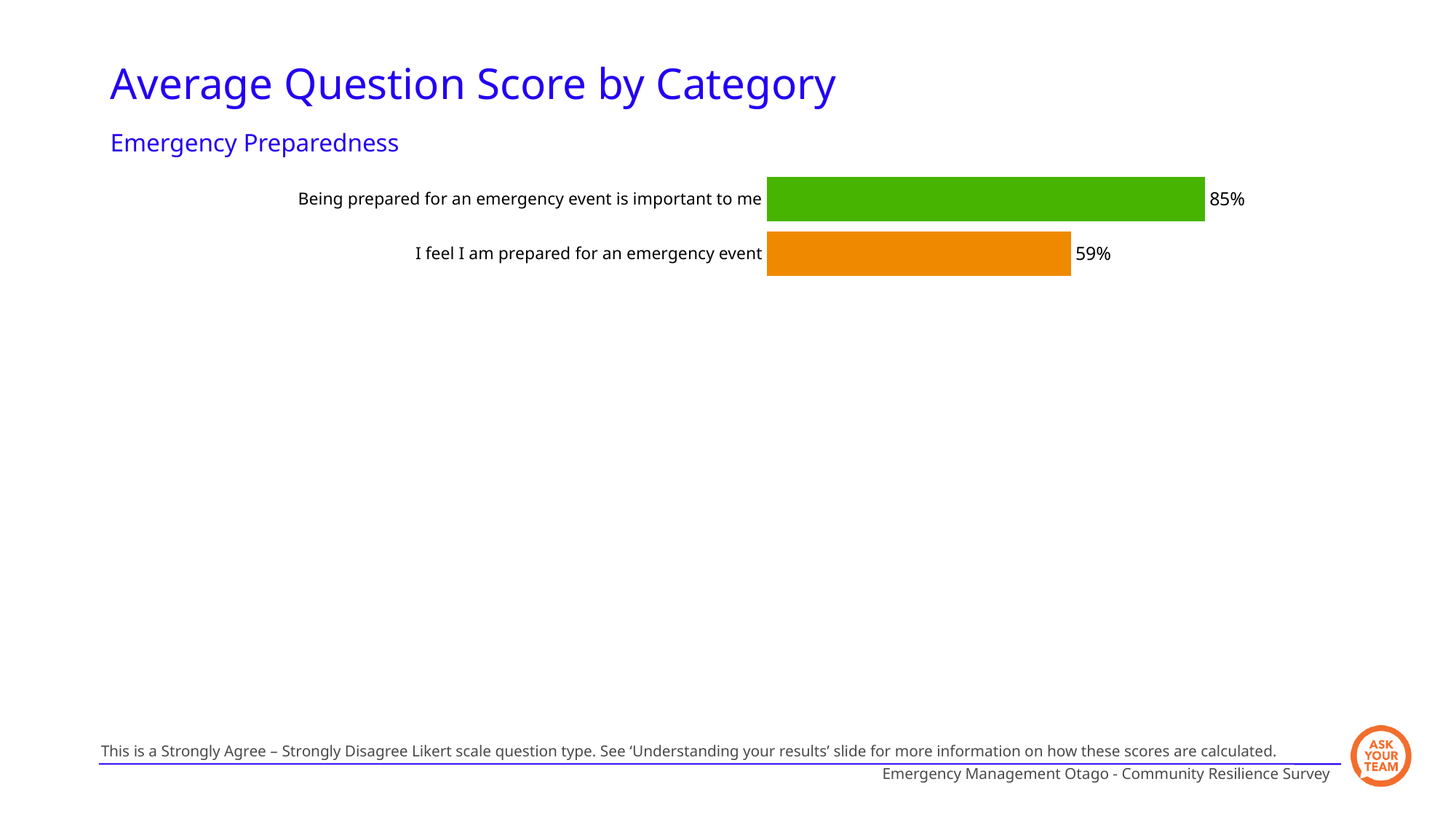
What is the average score for "Being prepared for an emergency event is important to me"? 85% Which question has the highest average score? Being prepared for an emergency event is important to me What is the average score for "I feel I am prepared for an emergency event"? 59% What is the difference between the scores for "Being prepared for an emergency event is important to me" and "I feel I am prepared for an emergency event"? 26% What colour is the bar for "I feel I am prepared for an emergency event"? Orange Which has a higher score: "I feel I am prepared for an emergency event" or "Being prepared for an emergency event is important to me"? Being prepared for an emergency event is important to me What type of chart is shown on the slide? Bar chart What category of questions does the chart cover? Emergency Preparedness How many questions are shown in the chart? 2 Which question has the lowest average score? I feel I am prepared for an emergency event